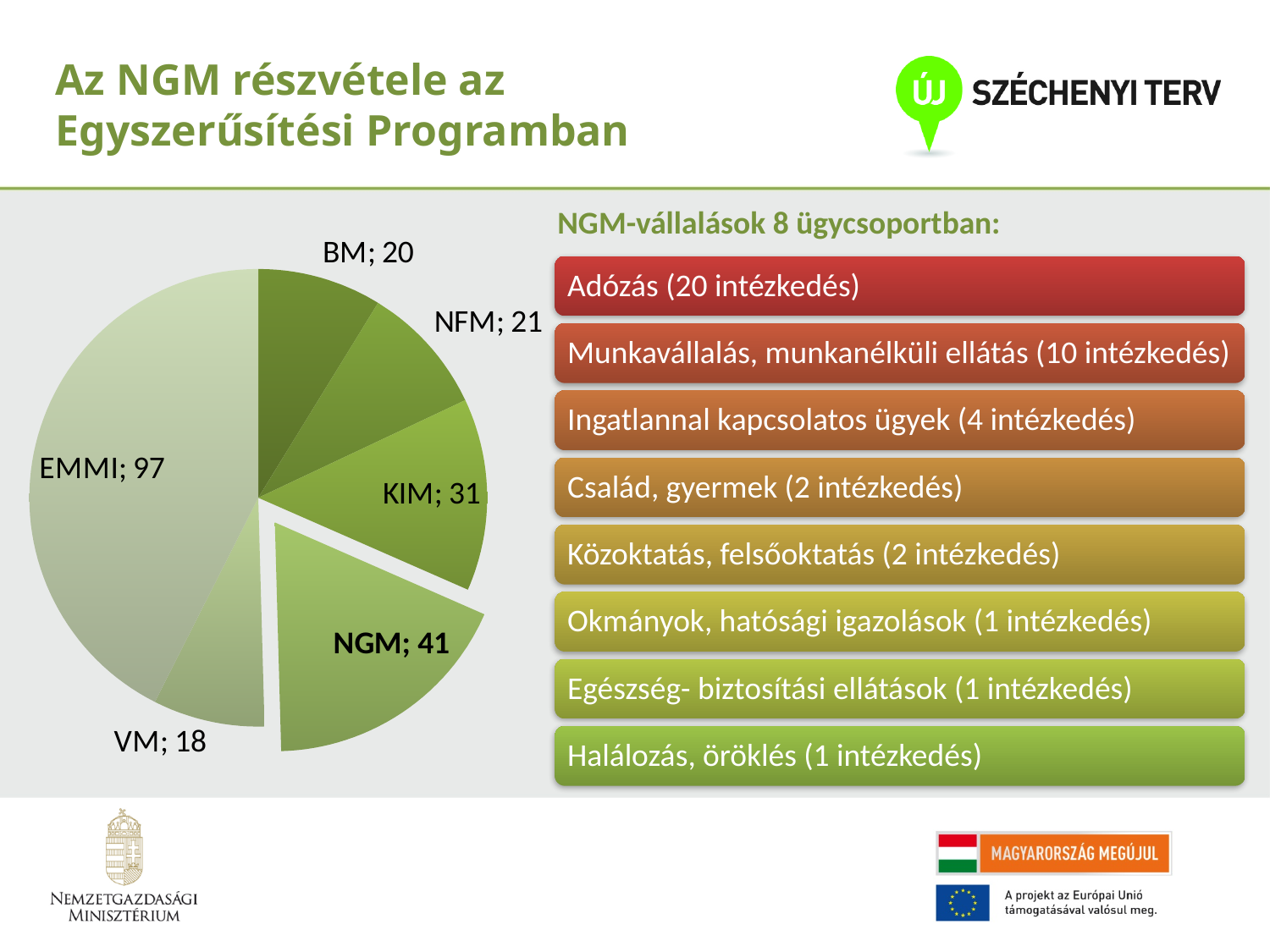
What is the difference between the values for KIM and BM in the pie chart? 11 Which slice of the pie chart is pulled out (exploded) from the rest? NGM How many categories (slices) does the pie chart show? 6 What value is shown for EMMI in the pie chart? 97 Which category has the smallest slice in the pie chart? VM Which is larger in the pie chart, the value for NFM or the value for VM? NFM What type of chart is shown on the slide? Pie chart What value is shown for NGM in the pie chart? 41 What is the difference between the values for EMMI and NGM in the pie chart? 56 What value is shown for VM in the pie chart? 18 What value is shown for KIM in the pie chart? 31 Which category has the largest slice in the pie chart? EMMI